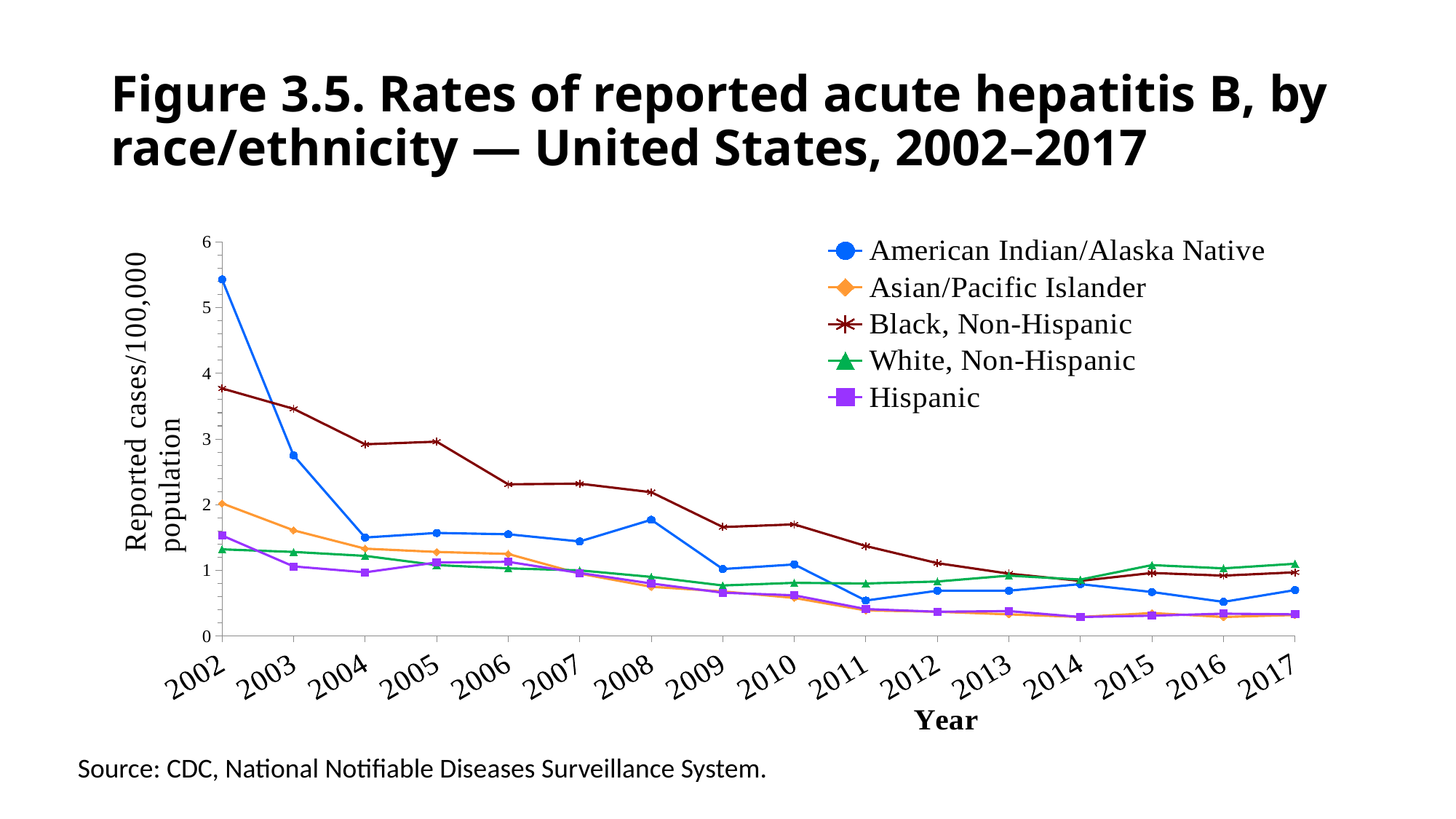
Is the 2002 value for Black, Non-Hispanic greater or less than 3? greater Which race/ethnicity group has the highest rate in 2010? Black, Non-Hispanic In 2017, which is higher: the rate for White, Non-Hispanic or for Hispanic? White, Non-Hispanic Which race/ethnicity group has the highest rate in 2002? American Indian/Alaska Native In 2003, which is higher: the rate for Black, Non-Hispanic or for American Indian/Alaska Native? Black, Non-Hispanic What kind of chart is shown on the slide? line chart Is the 2002 value for American Indian/Alaska Native greater or less than 5? greater What is the label on the y axis? Reported cases/100,000 population Is the 2017 value for Hispanic greater or less than 1? less How many years are shown along the x axis? 16 How many series does the legend list? 5 Does the rate for Black, Non-Hispanic rise or fall from 2002 to 2017? fall